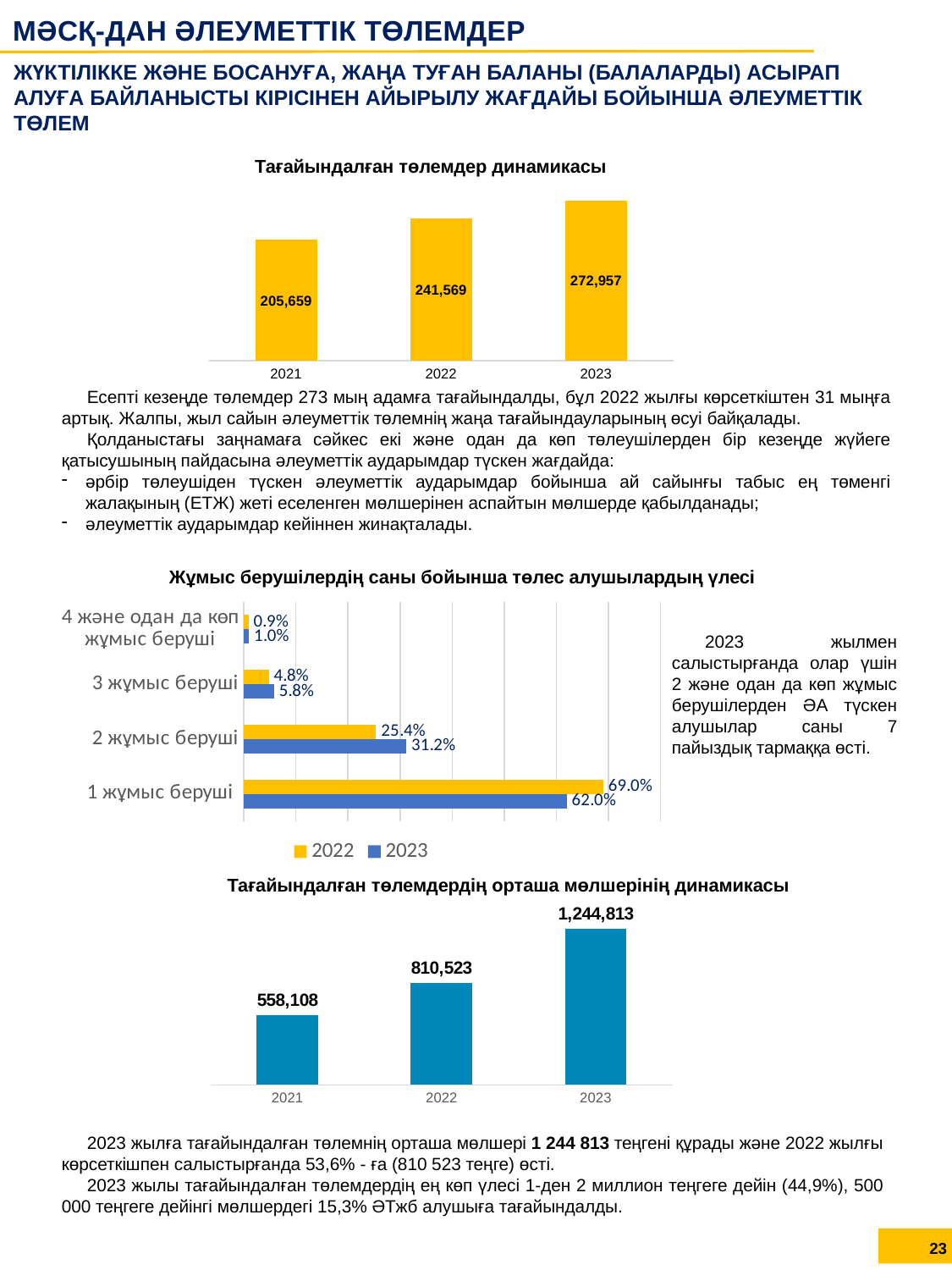
In the chart 'Жұмыс берушілердің саны бойынша төлес алушылардың үлесі', what is the 2022 value for '1 жұмыс беруші'? 69.0% In the chart 'Жұмыс берушілердің саны бойынша төлес алушылардың үлесі', which category has the lowest 2023 value? 4 және одан да көп жұмыс беруші In the chart 'Тағайындалған төлемдер динамикасы', do the values rise or fall from 2021 to 2023? rise In the chart 'Жұмыс берушілердің саны бойынша төлес алушылардың үлесі', how many series does the legend list? 2 In the chart 'Тағайындалған төлемдердің орташа мөлшерінің динамикасы', which year has the highest value? 2023 In the chart 'Жұмыс берушілердің саны бойынша төлес алушылардың үлесі', what is the 2023 value for '2 жұмыс беруші'? 31.2% In the chart 'Тағайындалған төлемдер динамикасы', what is the difference between the 2023 and 2022 values? 31,388 In the chart 'Жұмыс берушілердің саны бойынша төлес алушылардың үлесі', which is larger for '3 жұмыс беруші': the 2022 value or the 2023 value? 2023 In the chart 'Тағайындалған төлемдер динамикасы', what is the value for 2023? 272,957 In the chart 'Тағайындалған төлемдердің орташа мөлшерінің динамикасы', what is the value for 2022? 810,523 What kind of chart is 'Тағайындалған төлемдердің орташа мөлшерінің динамикасы'? bar chart In the chart 'Тағайындалған төлемдер динамикасы', what is the value for 2021? 205,659